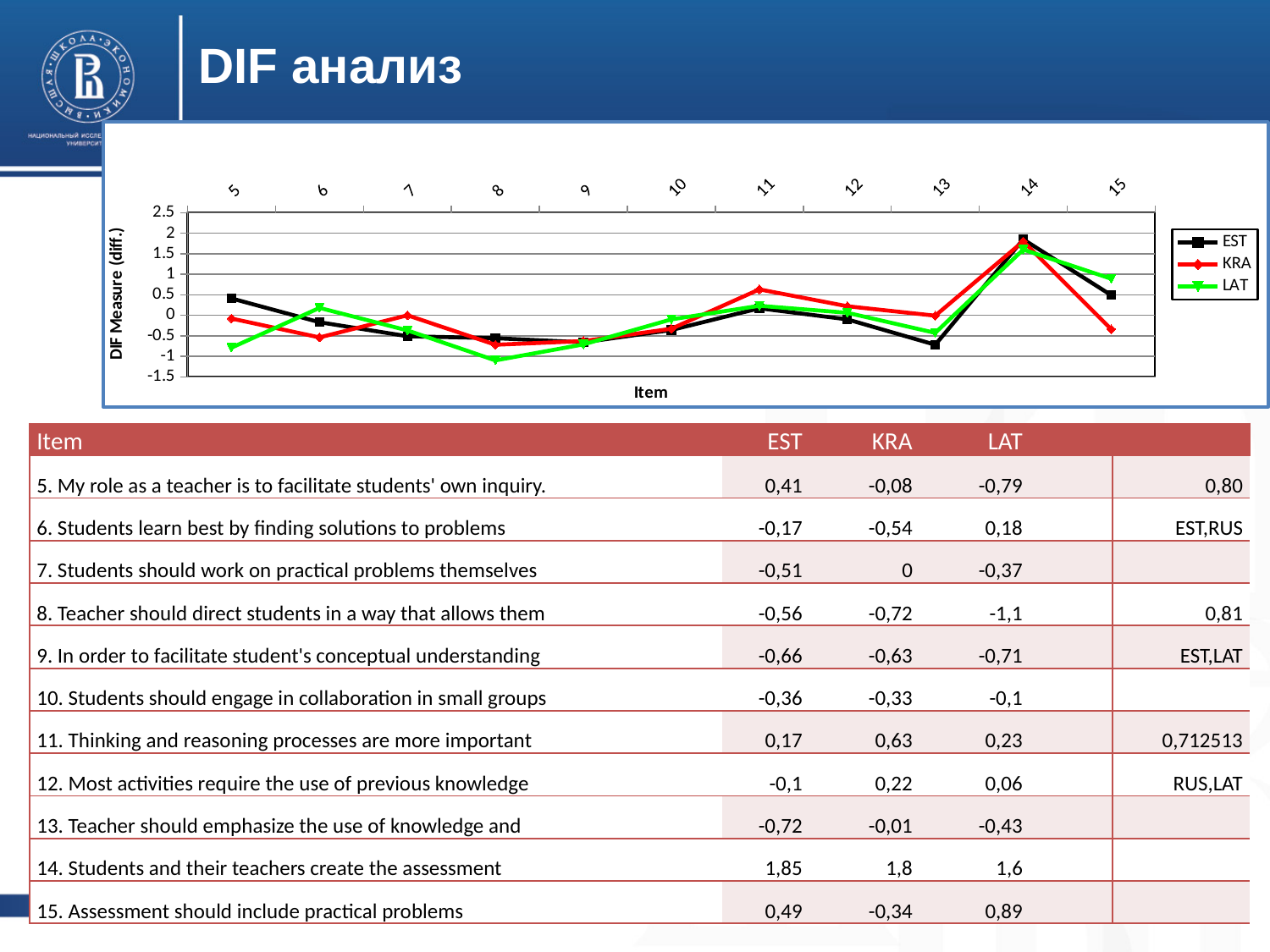
How many series does the chart legend list? 3 What is the EST value for item 14? 1,85 What kind of chart is shown on the slide? line chart Which item has the highest EST value? 14 Does the EST line rise or fall from item 13 to item 14? rise What is the title of the chart's vertical axis? DIF Measure (diff.) What is the difference between the EST and KRA values for item 14? 0,05 Is the KRA value for item 14 greater or less than 1? greater What is the LAT value for item 8? -1,1 Which item has the lowest LAT value? 8 How many items are plotted along the x axis of the chart? 11 For item 11, which is larger, the KRA value or the EST value? KRA